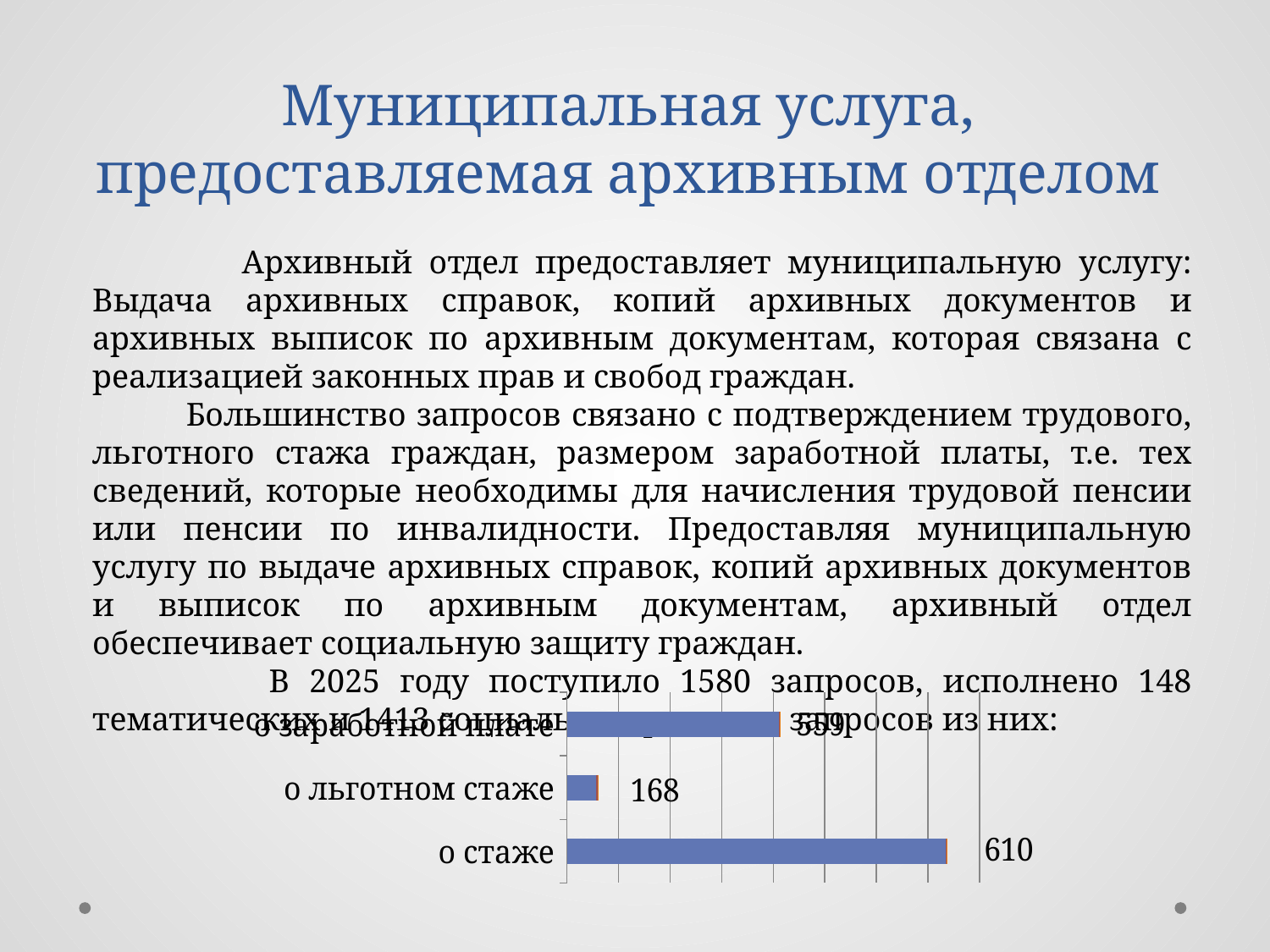
What is the value for "о стаже" in the chart? 610 Which is larger, the value for "о стаже" or the value for "о льготном стаже"? о стаже What colour are the bars in the chart? blue What is the difference between the values for "о стаже" and "о льготном стаже"? 442 Which is larger, the value for "о заработной плате" or the value for "о льготном стаже"? о заработной плате Which category has the highest value in the chart? о стаже What is the value for "о льготном стаже" in the chart? 168 What kind of chart is shown on the slide? bar chart How many categories are shown in the chart? 3 Which category has the lowest value in the chart? о льготном стаже